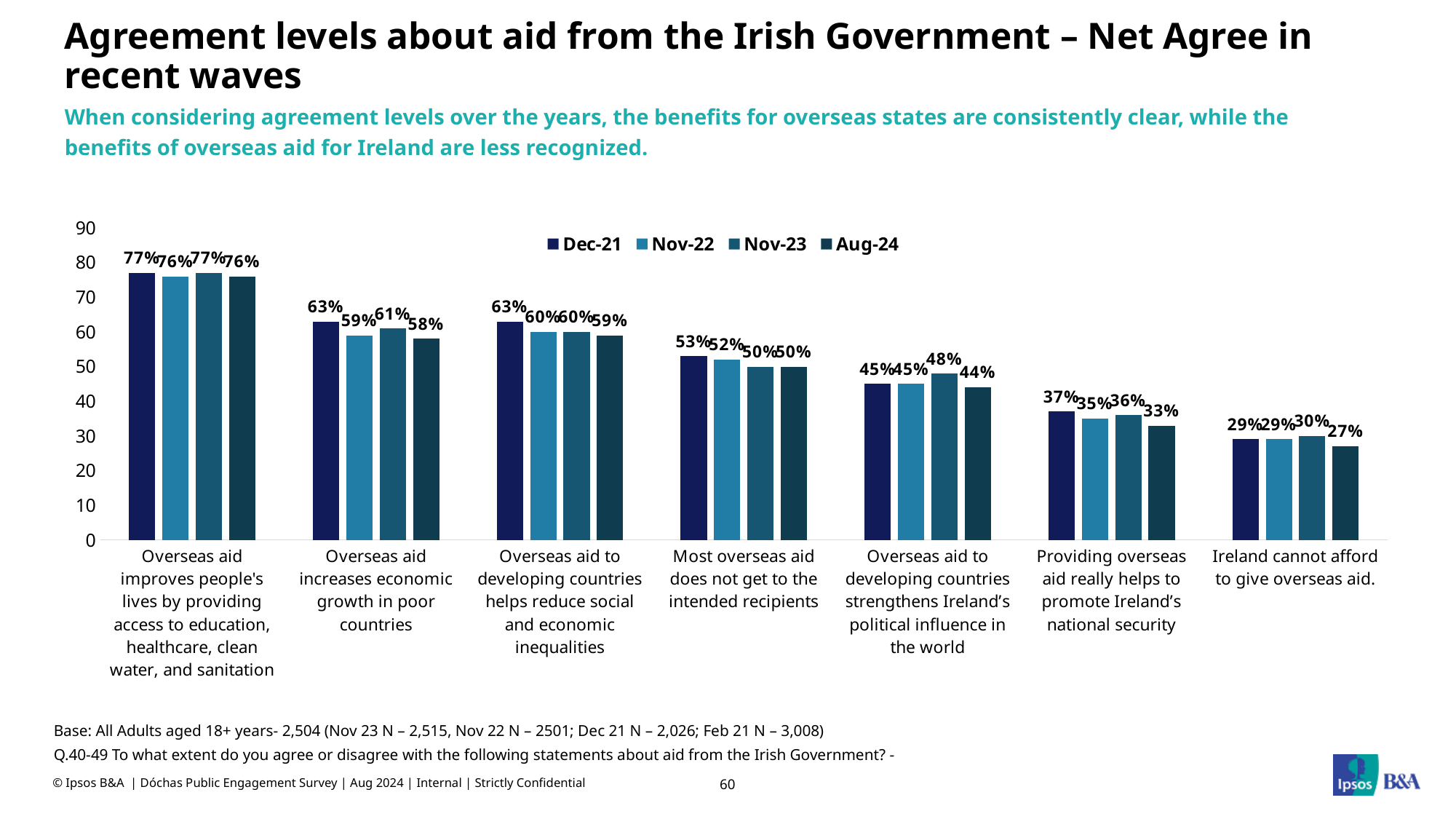
Which statement has the highest Aug-24 value? Overseas aid improves people's lives by providing access to education, healthcare, clean water, and sanitation What is the difference between the Dec-21 and Aug-24 values for 'Overseas aid increases economic growth in poor countries'? 5 percentage points Which is larger for 'Providing overseas aid really helps to promote Ireland's national security': the Dec-21 value or the Aug-24 value? Dec-21 How many series does the legend list? 4 Do the Aug-24 values rise or fall moving from left to right across the statements? Fall What kind of chart is shown on the slide? Bar chart What is the Aug-24 value for 'Ireland cannot afford to give overseas aid.'? 27% How many statements (categories) are shown on the x axis? 7 Which statement has the lowest Dec-21 value? Ireland cannot afford to give overseas aid. Which wave is listed first in the legend? Dec-21 What is the Nov-23 value for 'Overseas aid to developing countries strengthens Ireland's political influence in the world'? 48% What is the Dec-21 value for 'Overseas aid increases economic growth in poor countries'? 63%